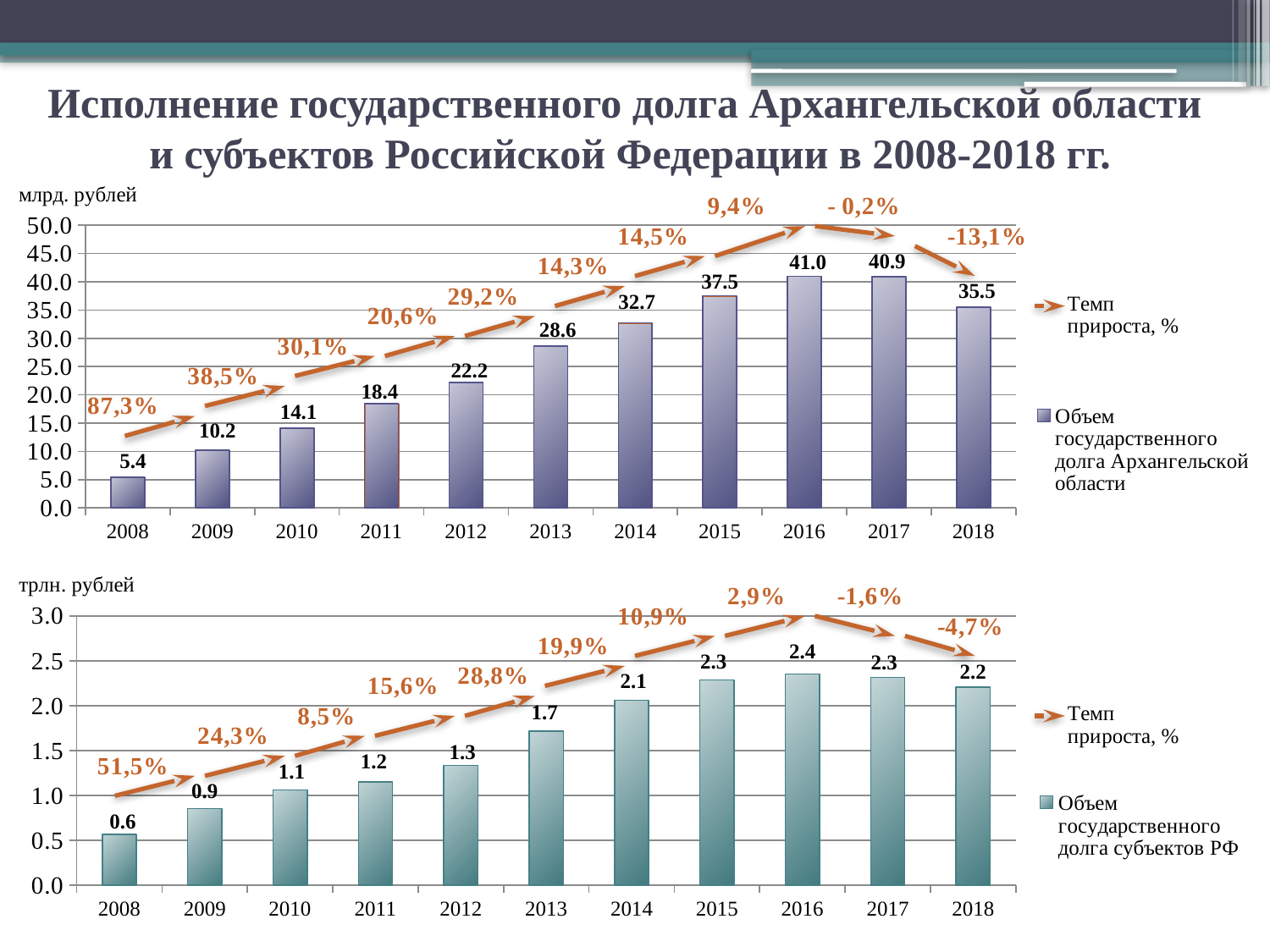
In the top chart, what growth rate (Темп прироста) is shown between 2008 and 2009? 87,3% In the bottom chart, what is the volume of state debt of the subjects of the RF in 2016? 2.4 In the top chart, which year has the lowest volume of state debt of the Arkhangelsk region? 2008 In the bottom chart, what growth rate (Темп прироста) is shown between 2017 and 2018? -4,7% In the top chart, how many years are shown on the x axis? 11 What type of chart is the bottom chart? bar chart In the top chart, which year has the highest volume of state debt of the Arkhangelsk region? 2016 In the bottom chart, what unit is indicated above the y axis? трлн. рублей In the bottom chart, what is the difference between the debt volume in 2016 and in 2008? 1.8 In the top chart, what is the volume of state debt of the Arkhangelsk region in 2012? 22.2 In the bottom chart, which is larger: the debt volume in 2013 or in 2014? 2014 In the top chart, what is the difference between the debt volume in 2018 and in 2008? 30.1